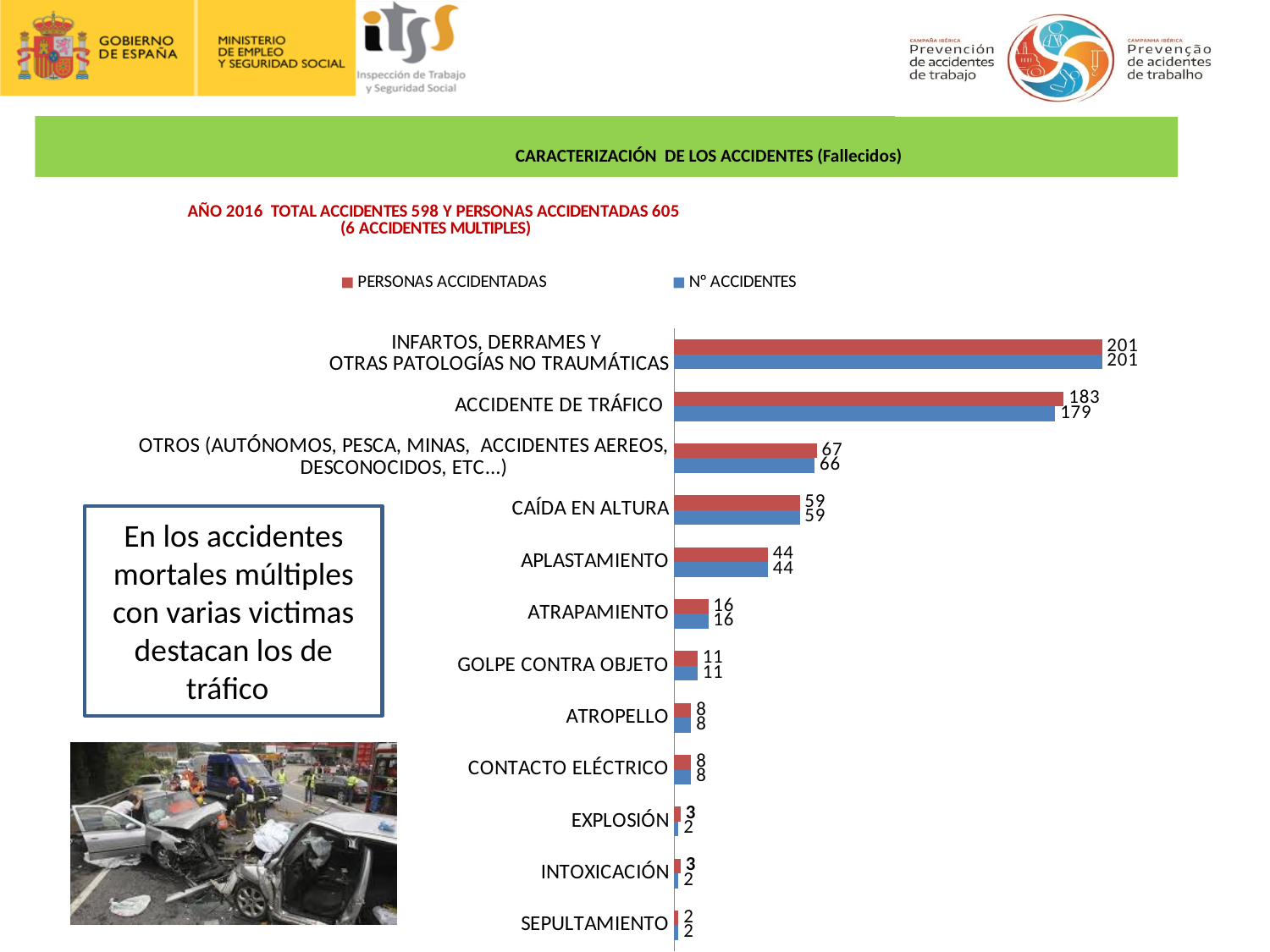
How many categories are plotted in the chart? 12 What is the value of Nº ACCIDENTES for CAÍDA EN ALTURA? 59 Which is larger: the Nº ACCIDENTES value for APLASTAMIENTO or for ATRAPAMIENTO? APLASTAMIENTO Which series in the legend is shown in red? PERSONAS ACCIDENTADAS Which category has the lowest value for PERSONAS ACCIDENTADAS? SEPULTAMIENTO What is the value of Nº ACCIDENTES for ACCIDENTE DE TRÁFICO? 179 What is the value of PERSONAS ACCIDENTADAS for EXPLOSIÓN? 3 What is the difference between PERSONAS ACCIDENTADAS and Nº ACCIDENTES for ACCIDENTE DE TRÁFICO? 4 What kind of chart is shown on the slide? bar chart Which category has the highest value for PERSONAS ACCIDENTADAS? INFARTOS, DERRAMES Y OTRAS PATOLOGÍAS NO TRAUMÁTICAS What is the value of PERSONAS ACCIDENTADAS for ACCIDENTE DE TRÁFICO? 183 How many series does the chart legend list? 2